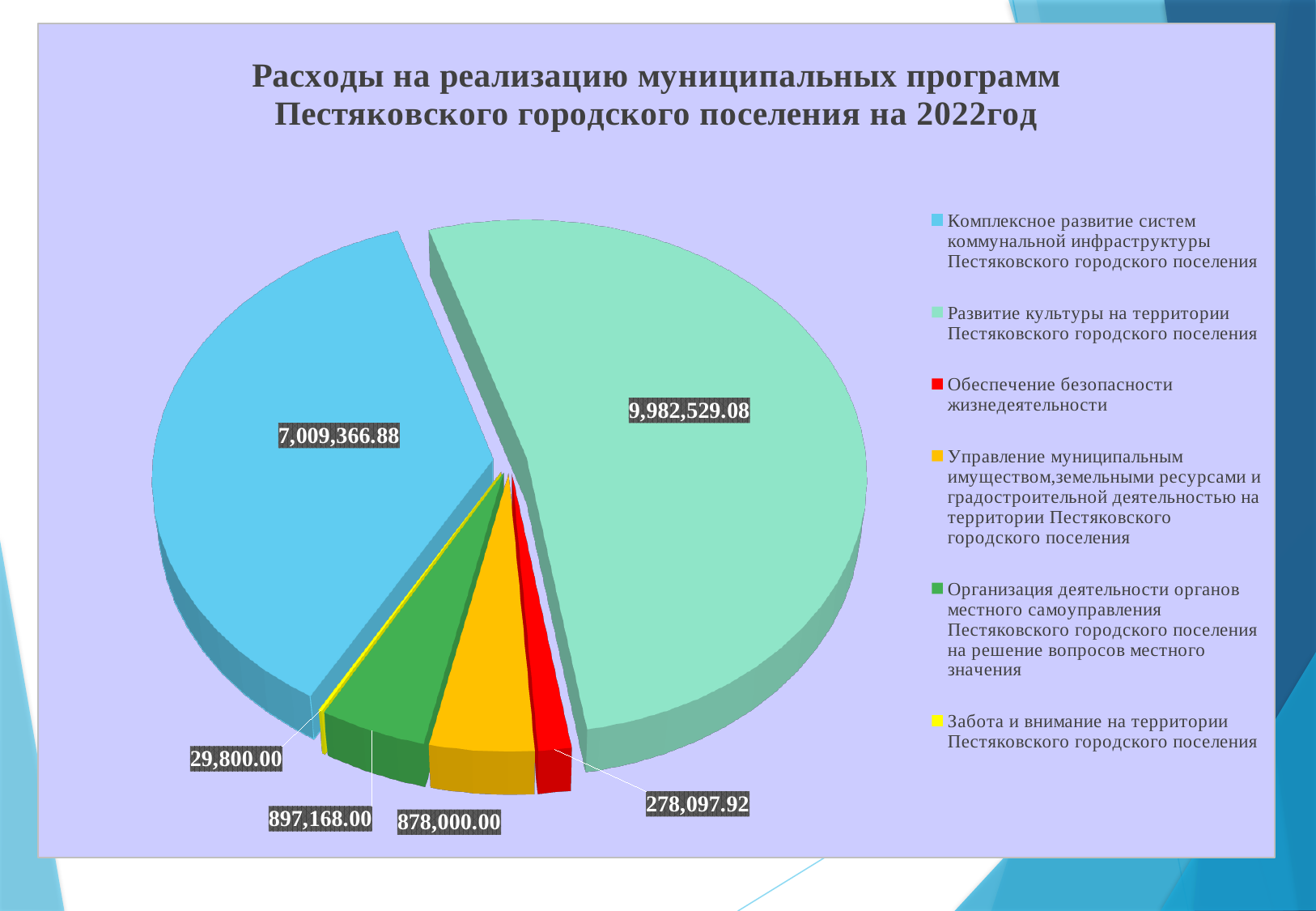
What is the value shown for Развитие культуры на территории Пестяковского городского поселения? 9,982,529.08 Which program has the smallest expenditure in the pie chart? Забота и внимание на территории Пестяковского городского поселения Which is larger: the value for Организация деятельности органов местного самоуправления or the value for Управление муниципальным имуществом? Организация деятельности органов местного самоуправления What type of chart is shown on the slide? Pie chart What colour is the slice for Обеспечение безопасности жизнедеятельности? Red What is the difference between the values for Развитие культуры and Комплексное развитие систем коммунальной инфраструктуры? 2,973,162.20 What is the value shown for Комплексное развитие систем коммунальной инфраструктуры Пестяковского городского поселения? 7,009,366.88 What is the value shown for Организация деятельности органов местного самоуправления Пестяковского городского поселения на решение вопросов местного значения? 897,168.00 How many slices does the pie chart have? 6 What is the value shown for Обеспечение безопасности жизнедеятельности? 278,097.92 What is the value shown for Забота и внимание на территории Пестяковского городского поселения? 29,800.00 Which program has the largest expenditure in the pie chart? Развитие культуры на территории Пестяковского городского поселения